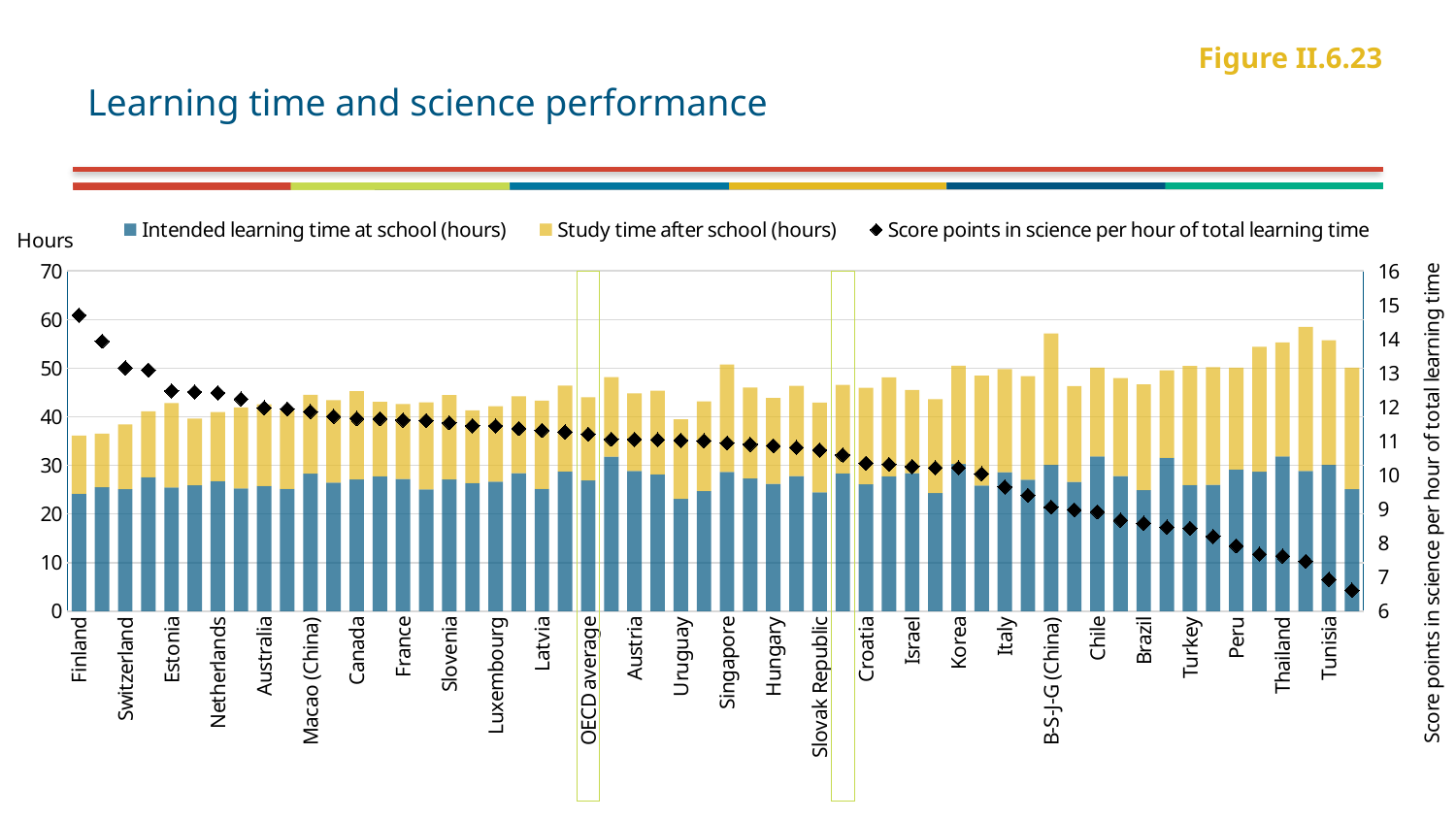
Is the total learning time (stacked bar) for Finland greater or less than 40 hours? less How many series does the legend list? 3 Which has the higher score points in science per hour of total learning time, Finland or Tunisia? Finland Which series is shown in yellow in the legend? Study time after school (hours) Is the score points in science per hour of total learning time for Finland greater or less than 14? greater Is the score points in science per hour of total learning time for Tunisia greater or less than 8? less Which has the taller total stacked bar, Finland or Thailand? Thailand What is the title of the chart? Learning time and science performance Which country has the highest score points in science per hour of total learning time? Finland What kind of chart is shown on the slide? A bar chart with stacked bars and a diamond marker series Do the diamond markers for score points in science per hour of total learning time rise or fall from left to right across the countries? Fall